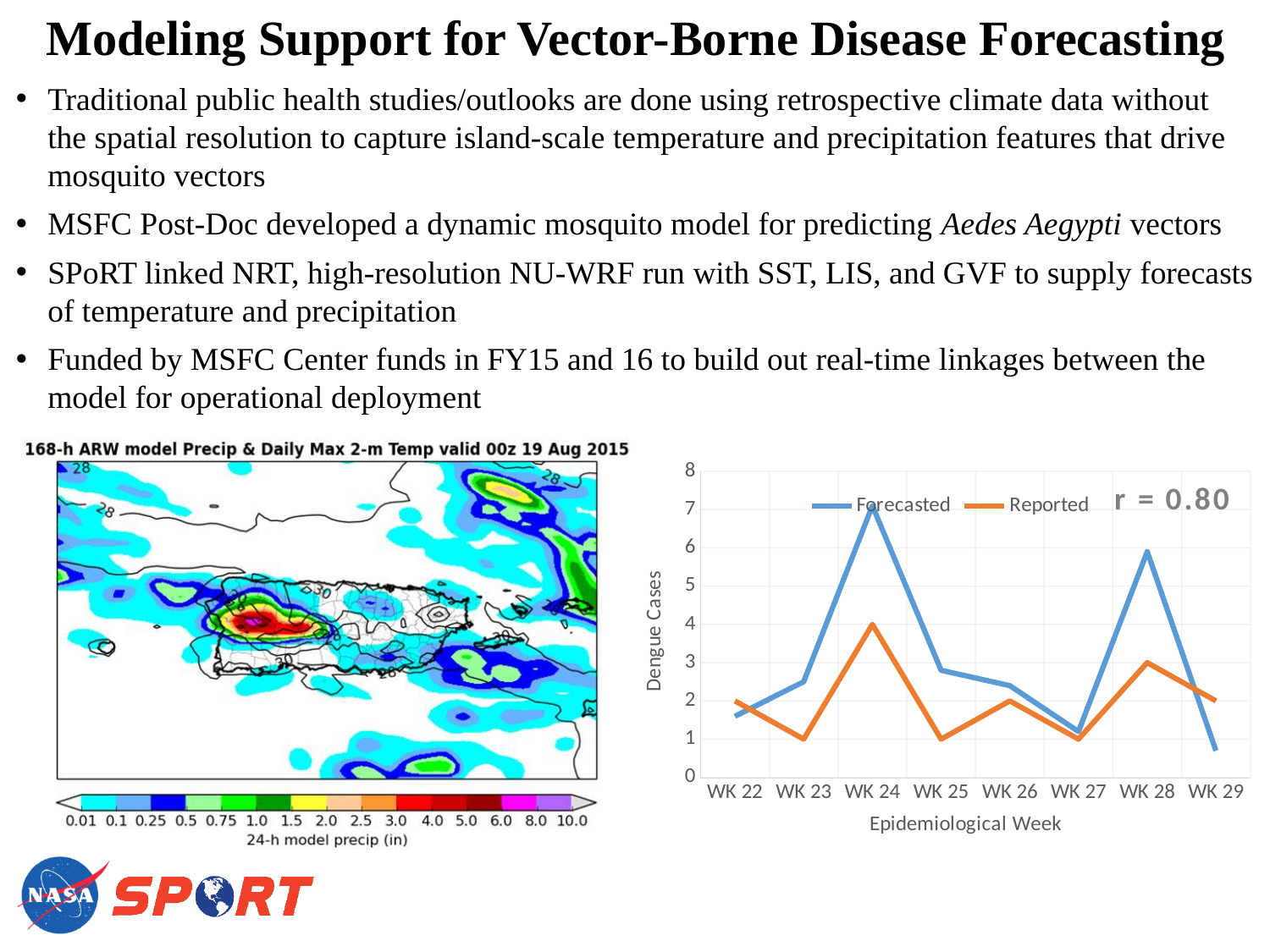
In the Dengue Cases chart, is the Forecasted value at WK 28 greater or less than 5? greater In the Dengue Cases chart, at which week does the Reported series reach its highest value? WK 24 In the Dengue Cases chart, at which week is the Forecasted series lowest? WK 29 What correlation value is printed on the Dengue Cases chart? r = 0.80 In the Dengue Cases chart, which series has the larger value at WK 29, Forecasted or Reported? Reported How many epidemiological weeks are shown on the x axis of the Dengue Cases chart? 8 In the Dengue Cases chart, does the Reported series rise or fall from WK 24 to WK 25? fall In the Dengue Cases chart, is the Forecasted value at WK 29 greater or less than 1? less How many series does the legend of the Dengue Cases chart list? 2 In the Dengue Cases chart, which series has the larger value at WK 24, Forecasted or Reported? Forecasted In the Dengue Cases chart, at which week does the Forecasted series reach its highest value? WK 24 What kind of chart is the Dengue Cases chart on the right of the slide? line chart